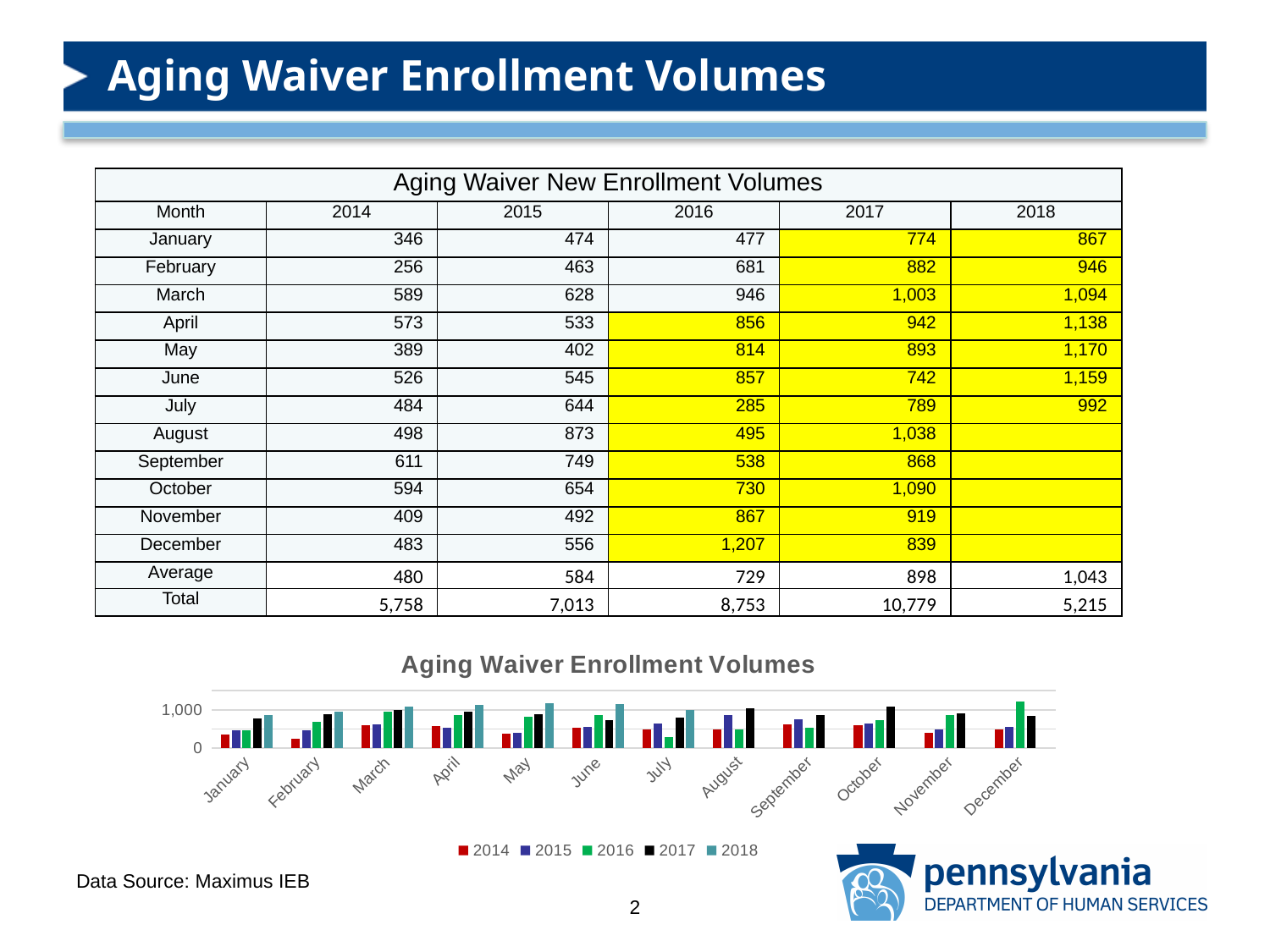
What is the title of the chart? Aging Waiver Enrollment Volumes In which month is the 2016 value highest? December Is the 2018 value for May greater or less than 1,000? greater Which is larger for August, the 2016 value or the 2017 value? 2017 Is the 2016 value for December greater or less than 1,000? greater How many months are shown along the x axis of the chart? 12 Which year is represented by the black bars in the chart? 2017 In which month is the 2014 value lowest? February How many series does the chart legend list? 5 Is the 2014 value for February greater or less than 1,000? less What is the 2018 enrollment volume for May? 1,170 What kind of chart is shown on the slide? bar chart